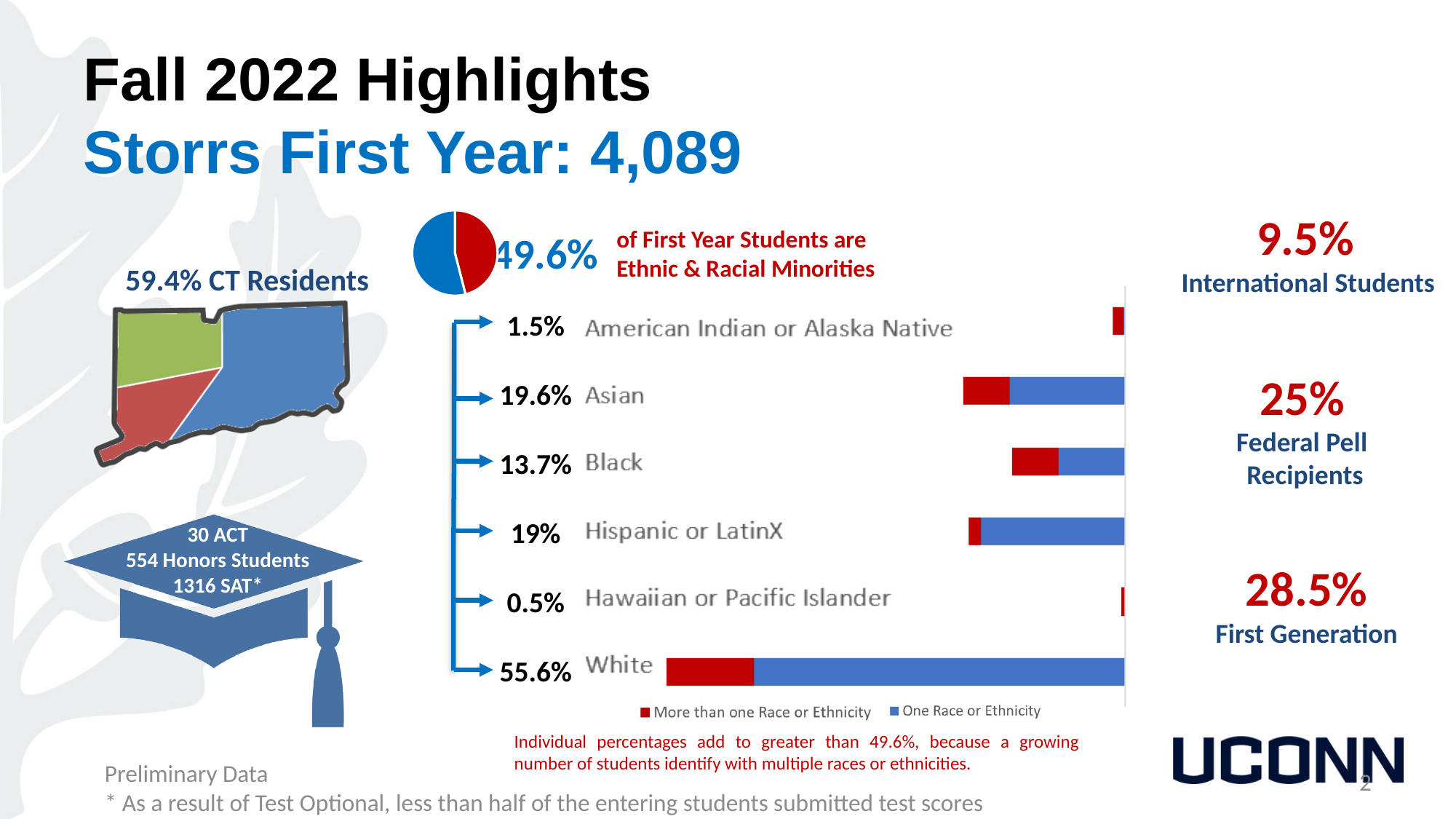
What kind of chart shows the race and ethnicity breakdown? Bar chart In the bar chart, which is larger, the percentage for Asian or for Black? Asian In the bar chart, which race or ethnicity category has the highest percentage? White In the bar chart, what is the difference in percentage points between White and Asian? 36 In the bar chart, which race or ethnicity category has the lowest percentage? Hawaiian or Pacific Islander How many race or ethnicity categories are shown in the bar chart? 6 In the bar chart, what percentage of first year students are Hawaiian or Pacific Islander? 0.5% In the bar chart, what percentage of first year students are Asian? 19.6% In the bar chart, what percentage of first year students are Hispanic or LatinX? 19% According to the pie chart, what share of first year students are ethnic and racial minorities? 49.6% In the bar chart, what percentage of first year students are Black? 13.7% How many series does the bar chart legend list? 2